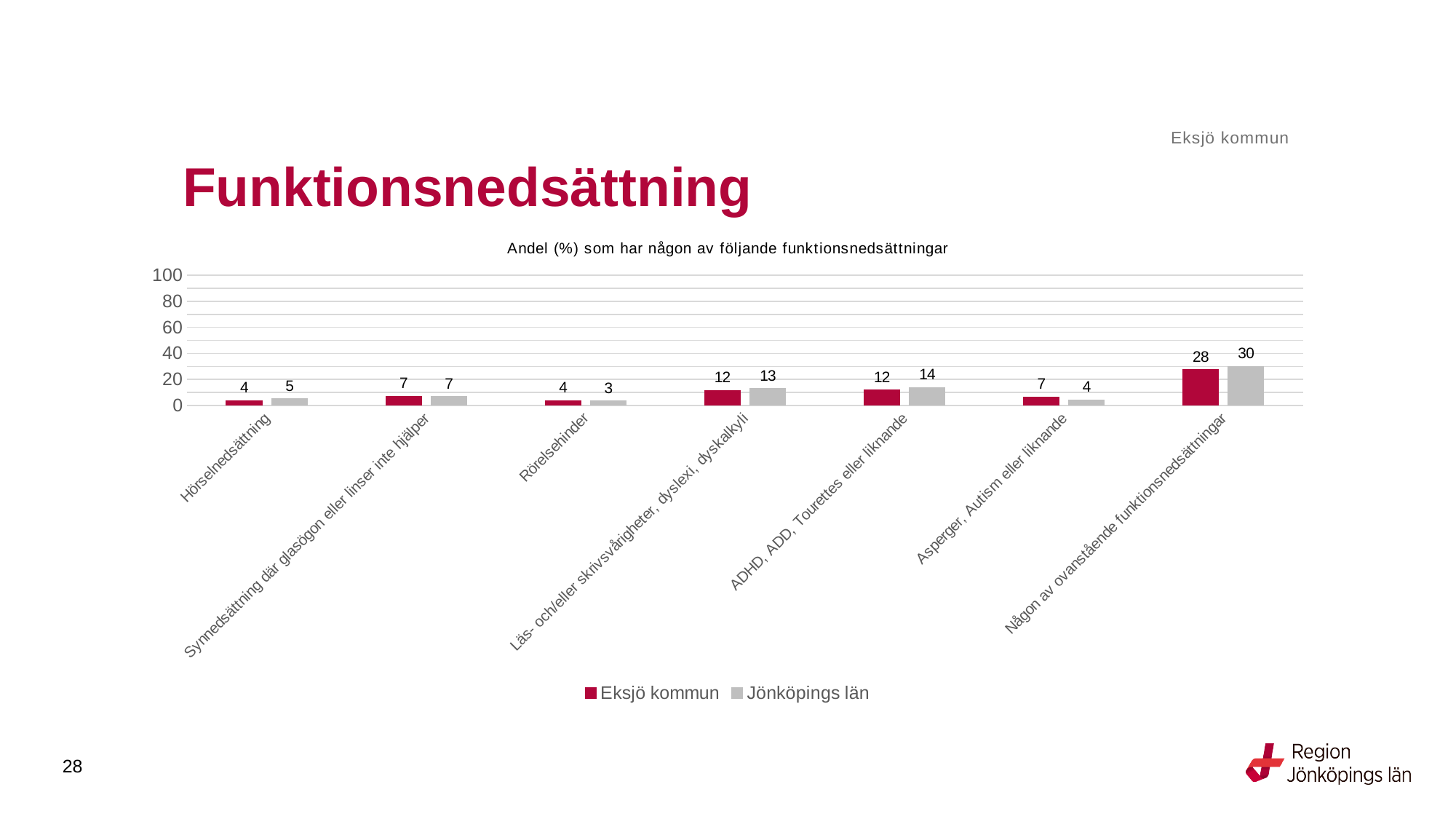
What is the value for Eksjö kommun for Hörselnedsättning? 4 What is the difference between Jönköpings län and Eksjö kommun for Asperger, Autism eller liknande? 3 Which category has the lowest value for Jönköpings län? Rörelsehinder How many series does the legend list? 2 What is the value for Jönköpings län for ADHD, ADD, Tourettes eller liknande? 14 What is the title of the chart? Andel (%) som har någon av följande funktionsnedsättningar Is the value for Jönköpings län for Någon av ovanstående funktionsnedsättningar greater or less than 20? greater What kind of chart is shown on the slide? Bar chart Which category has the highest value for Jönköpings län? Någon av ovanstående funktionsnedsättningar For Läs- och/eller skrivsvårigheter, dyslexi, dyskalkyli, which is larger: Eksjö kommun or Jönköpings län? Jönköpings län What is the value for Eksjö kommun for Någon av ovanstående funktionsnedsättningar? 28 How many categories are shown on the x axis? 7